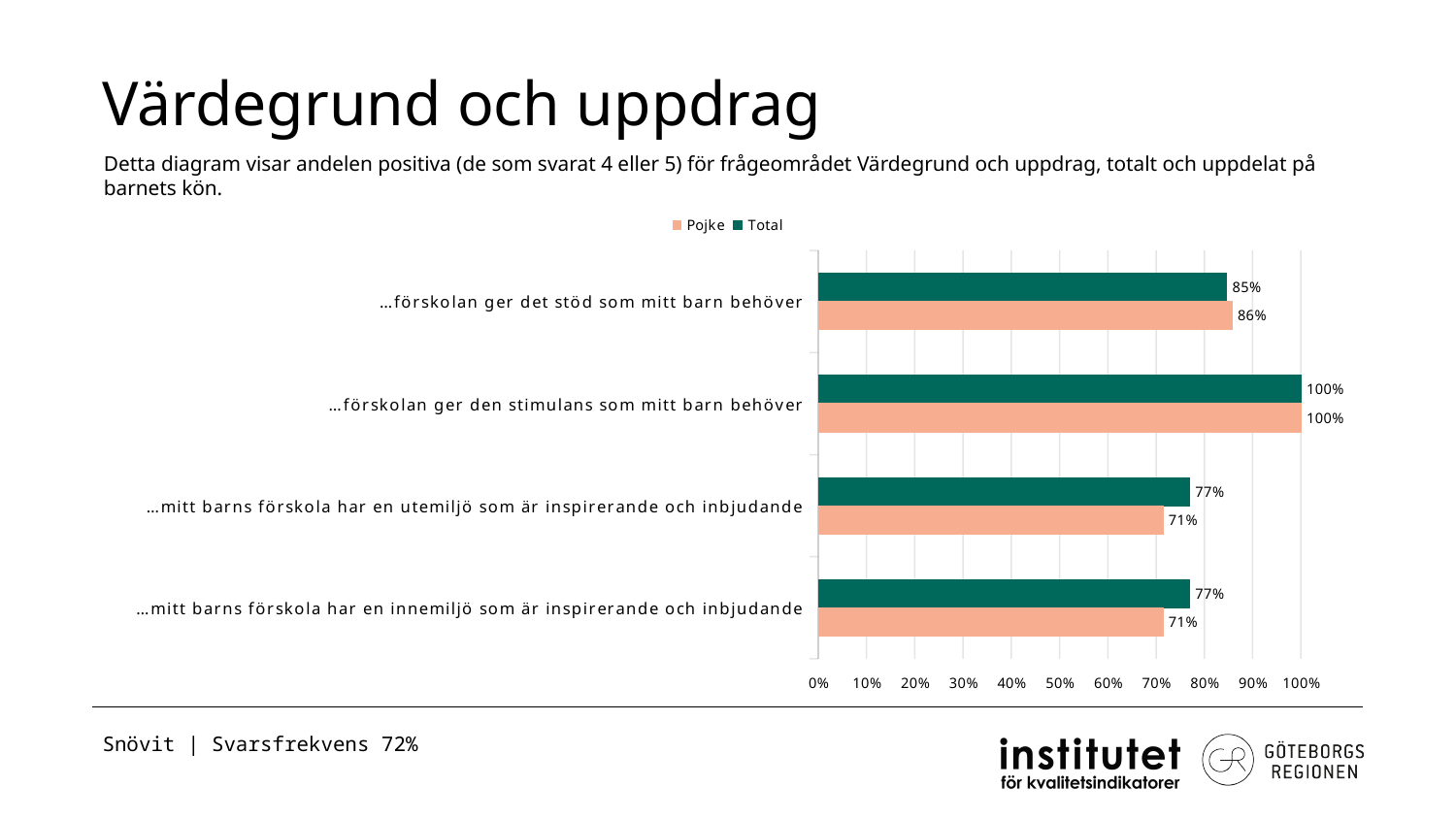
What is the Total value for "…mitt barns förskola har en innemiljö som är inspirerande och inbjudande"? 77% Which category has the lowest Pojke value? …mitt barns förskola har en utemiljö som är inspirerande och inbjudande and …mitt barns förskola har en innemiljö som är inspirerande och inbjudande (both 71%) What is the Total value for "…förskolan ger det stöd som mitt barn behöver"? 85% How many categories are shown in the chart? 4 What is the Pojke value for "…förskolan ger det stöd som mitt barn behöver"? 86% What kind of chart is shown on the slide? Bar chart Which colour represents the Total series in the chart? Green Which category has the highest Total value? …förskolan ger den stimulans som mitt barn behöver How many series does the legend list? 2 What is the Pojke value for "…mitt barns förskola har en utemiljö som är inspirerande och inbjudande"? 71% What is the difference between the Total and Pojke values for "…mitt barns förskola har en utemiljö som är inspirerande och inbjudande"? 6 percentage points For "…förskolan ger det stöd som mitt barn behöver", which is larger, the Pojke value or the Total value? Pojke